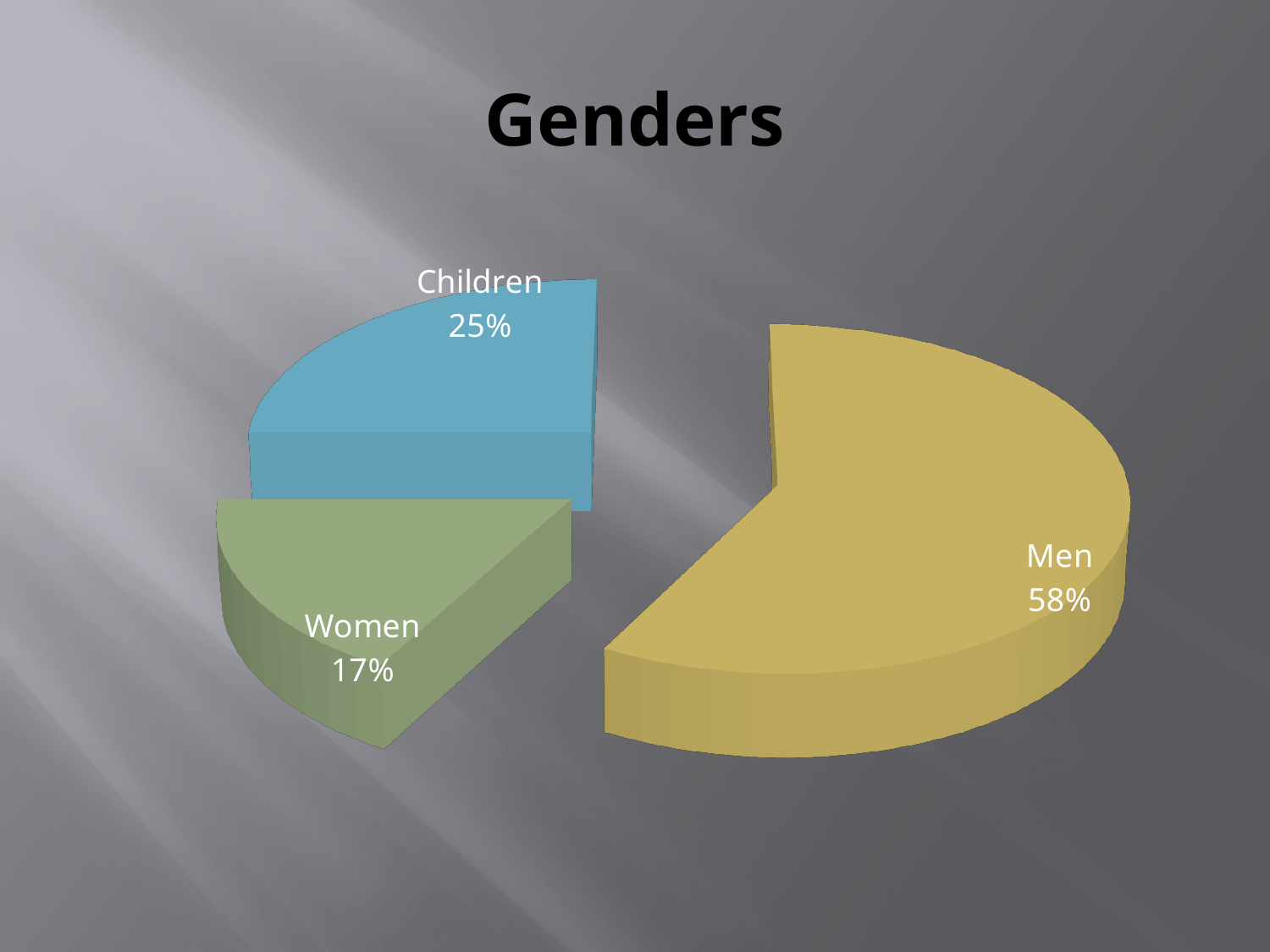
Which slice is larger, Men or Children? Men What is the difference in percentage points between the Men and Women slices? 41 Which slice is larger, Children or Women? Children How many slices does the pie chart have? 3 What share of the pie does Children represent? 25% What is the title of the chart? Genders What is the difference in percentage points between the Children and Women slices? 8 What kind of chart is shown on the slide? Pie chart What share of the pie does Women represent? 17% What share of the pie does Men represent? 58% Which category has the largest slice of the pie? Men Which category has the smallest slice of the pie? Women